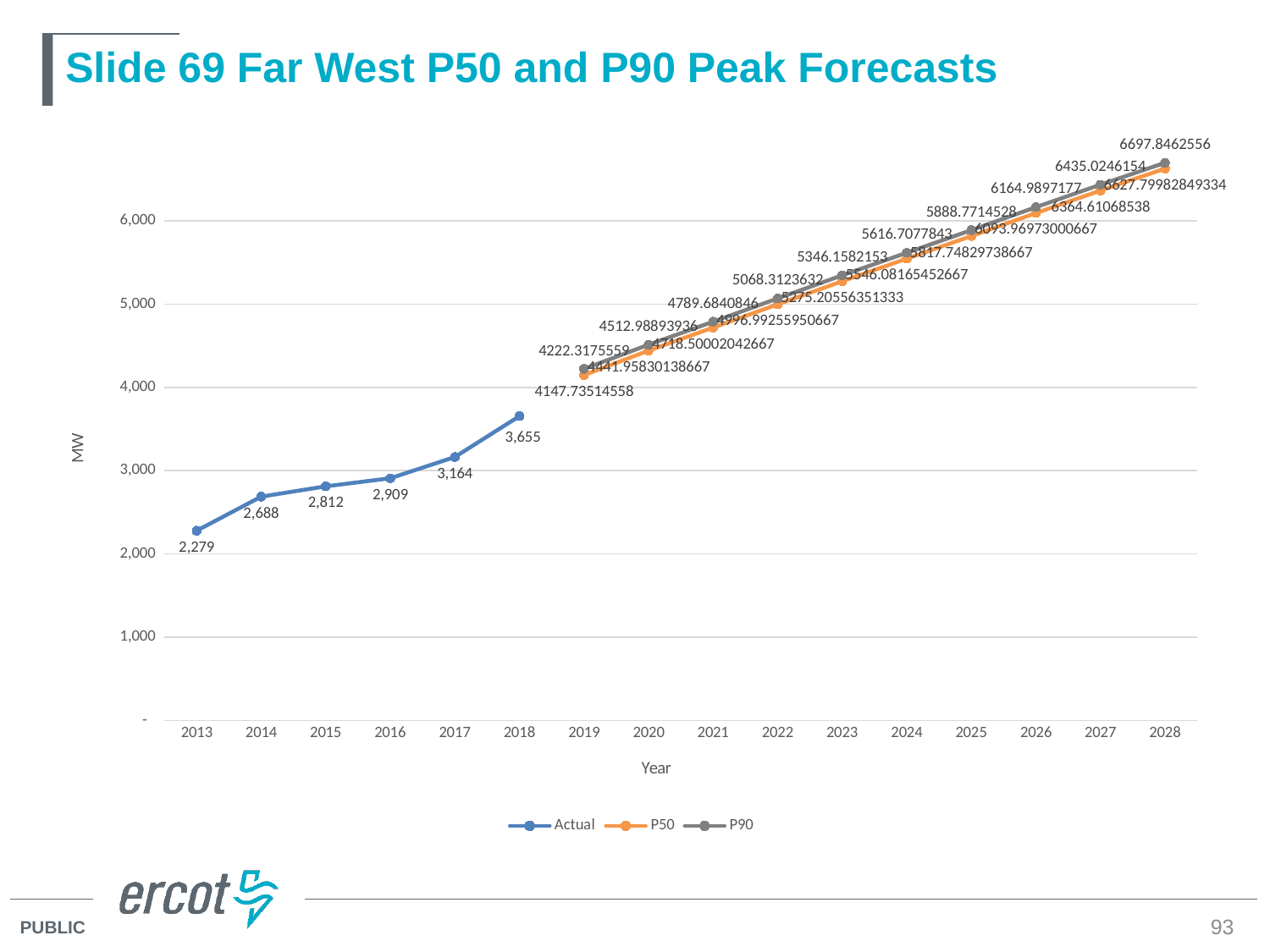
Do the values rise or fall from 2013 to 2028? rise What is the Actual value for 2013? 2,279 How many series does the legend list? 3 In 2028, which is larger, the P90 or the P50 forecast? P90 Which year has the highest Actual value? 2018 What is the P50 forecast value for 2019? 4147.73514558 What is the label on the y axis? MW What is the P90 forecast value for 2028? 6697.8462556 What is the Actual value for 2018? 3,655 What is the difference between the Actual values for 2018 and 2013? 1,376 What type of chart is shown on the slide? line chart How many years are shown on the x axis? 16